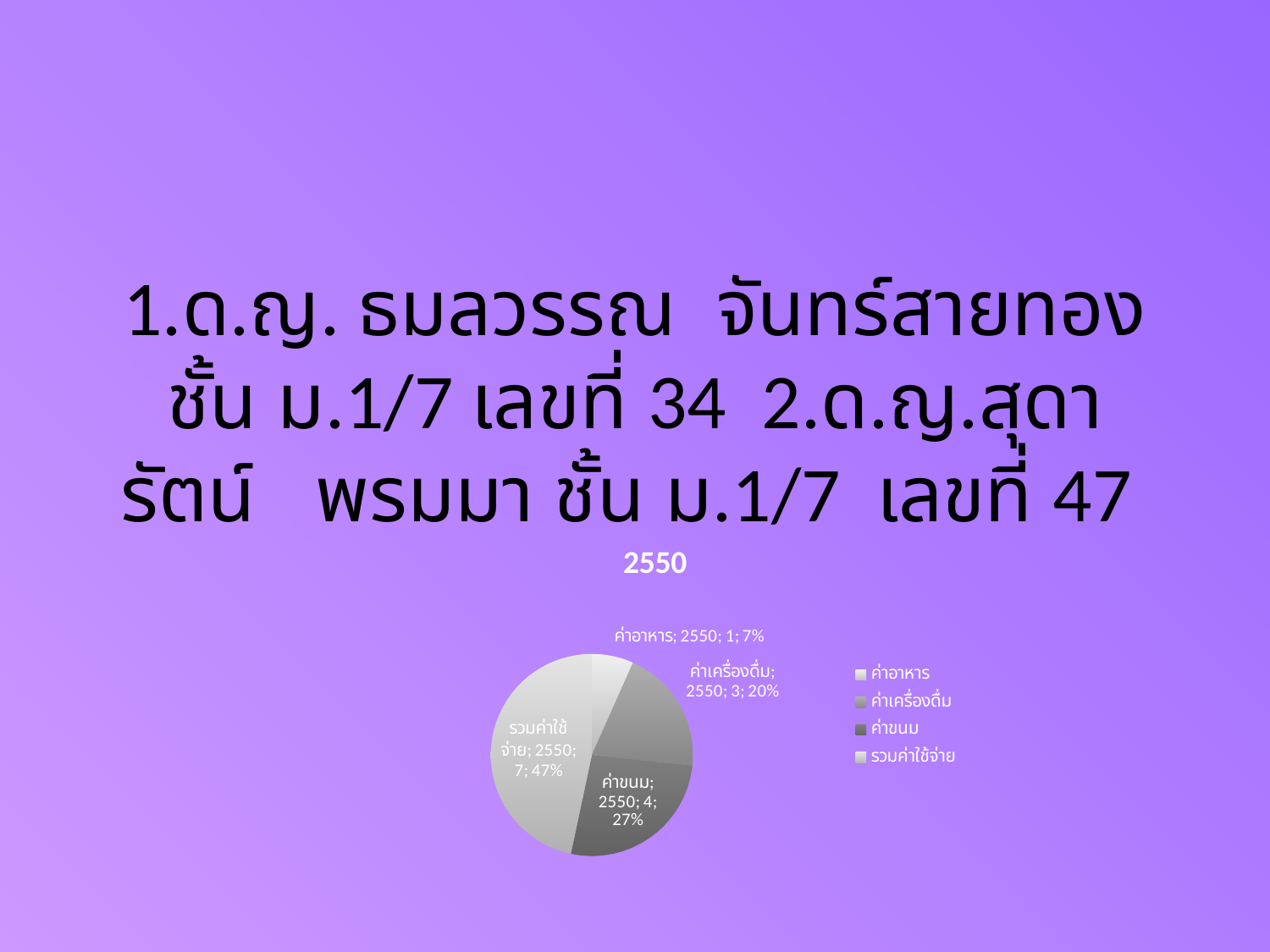
What kind of chart is shown on the slide? pie chart How many slices does the pie chart have? 4 What is the title of the chart? 2550 What is the value for ค่าเครื่องดื่ม? 3 What is the value for ค่าอาหาร? 1 What share of the pie does รวมค่าใช้จ่าย represent? 47% How many entries does the legend list? 4 Which category has the smallest slice? ค่าอาหาร What share of the pie does ค่าขนม represent? 27% What is the value for ค่าขนม? 4 What is the value for รวมค่าใช้จ่าย? 7 Which category has the largest slice? รวมค่าใช้จ่าย